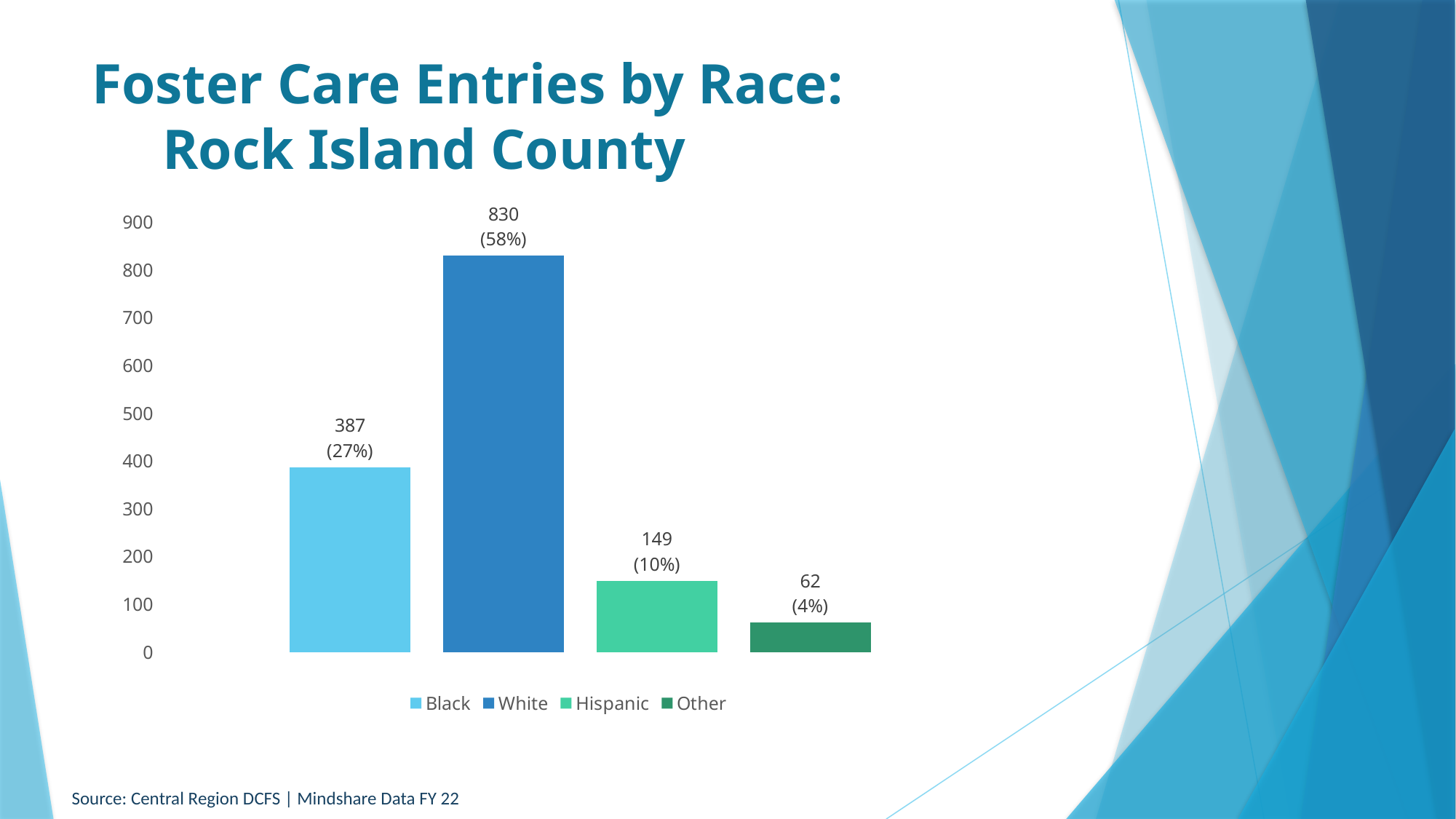
How many race categories are shown in the chart? 4 What is the number of foster care entries for Other? 62 What is the title of the slide? Foster Care Entries by Race: Rock Island County What kind of chart is shown on the slide? Bar chart What is the number of foster care entries for White? 830 What is the difference between the number of entries for White and Black? 443 What is the number of foster care entries for Black? 387 What percentage of foster care entries is shown for Hispanic? 10% Which has more foster care entries, Hispanic or Other? Hispanic Which race category has the highest number of foster care entries? White Which race category has the lowest number of foster care entries? Other Is the value for Black greater or less than 300? greater